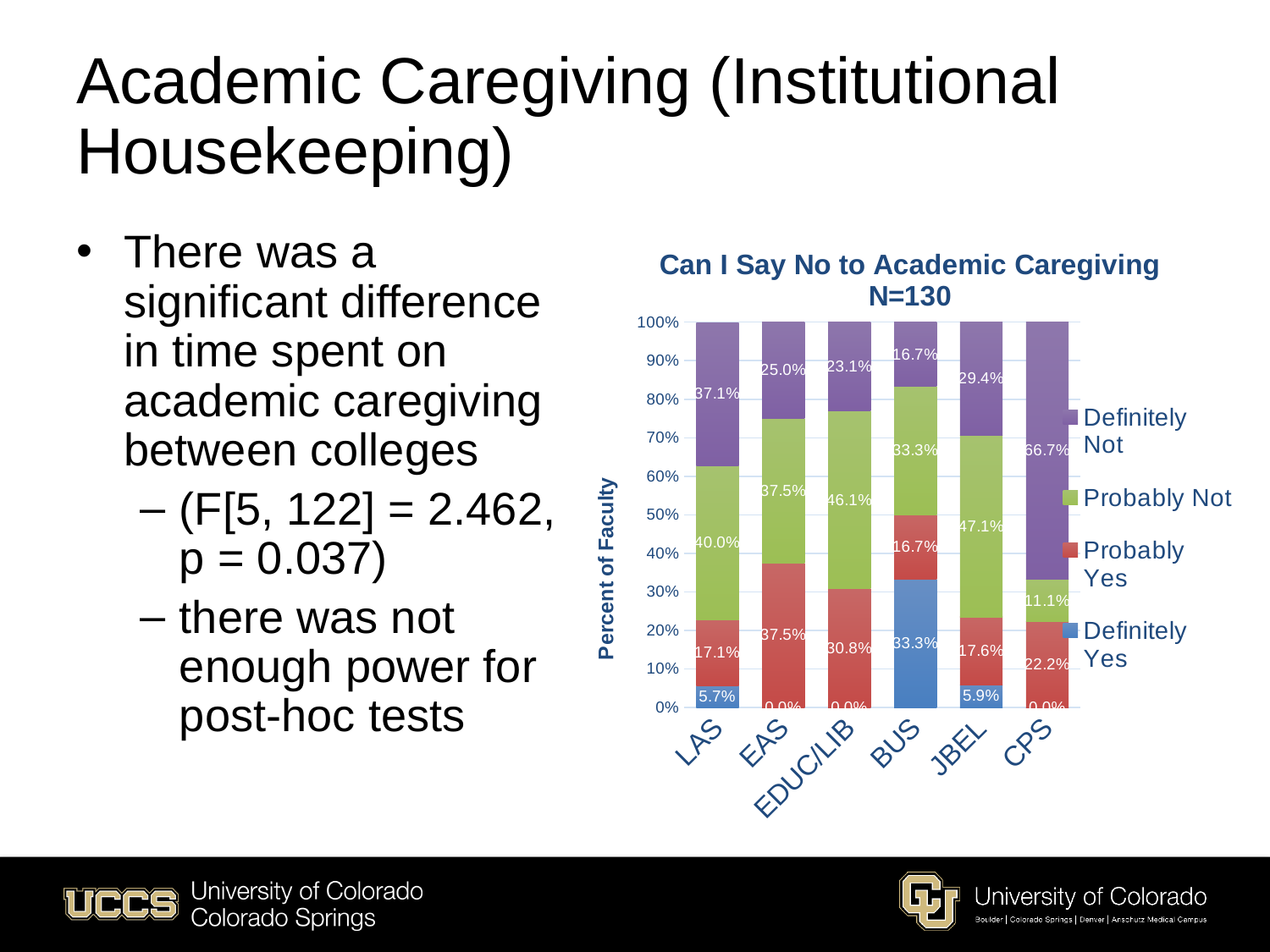
What kind of chart is shown on the slide? Stacked bar chart Which college has the lowest "Probably Not" percentage? CPS What is the "Definitely Not" value for CPS? 66.7% What is the label on the vertical axis of the chart? Percent of Faculty Which is larger for EDUC/LIB: the "Probably Not" value or the "Probably Yes" value? Probably Not Which college has the highest "Definitely Not" percentage? CPS What percentage of LAS faculty answered "Definitely Yes"? 5.7% What percentage of BUS faculty answered "Definitely Yes"? 33.3% How many colleges are shown on the x axis? 6 What is the difference between the "Probably Not" and "Probably Yes" values for LAS? 22.9% How many series does the legend list? 4 What is the "Probably Not" value for JBEL? 47.1%